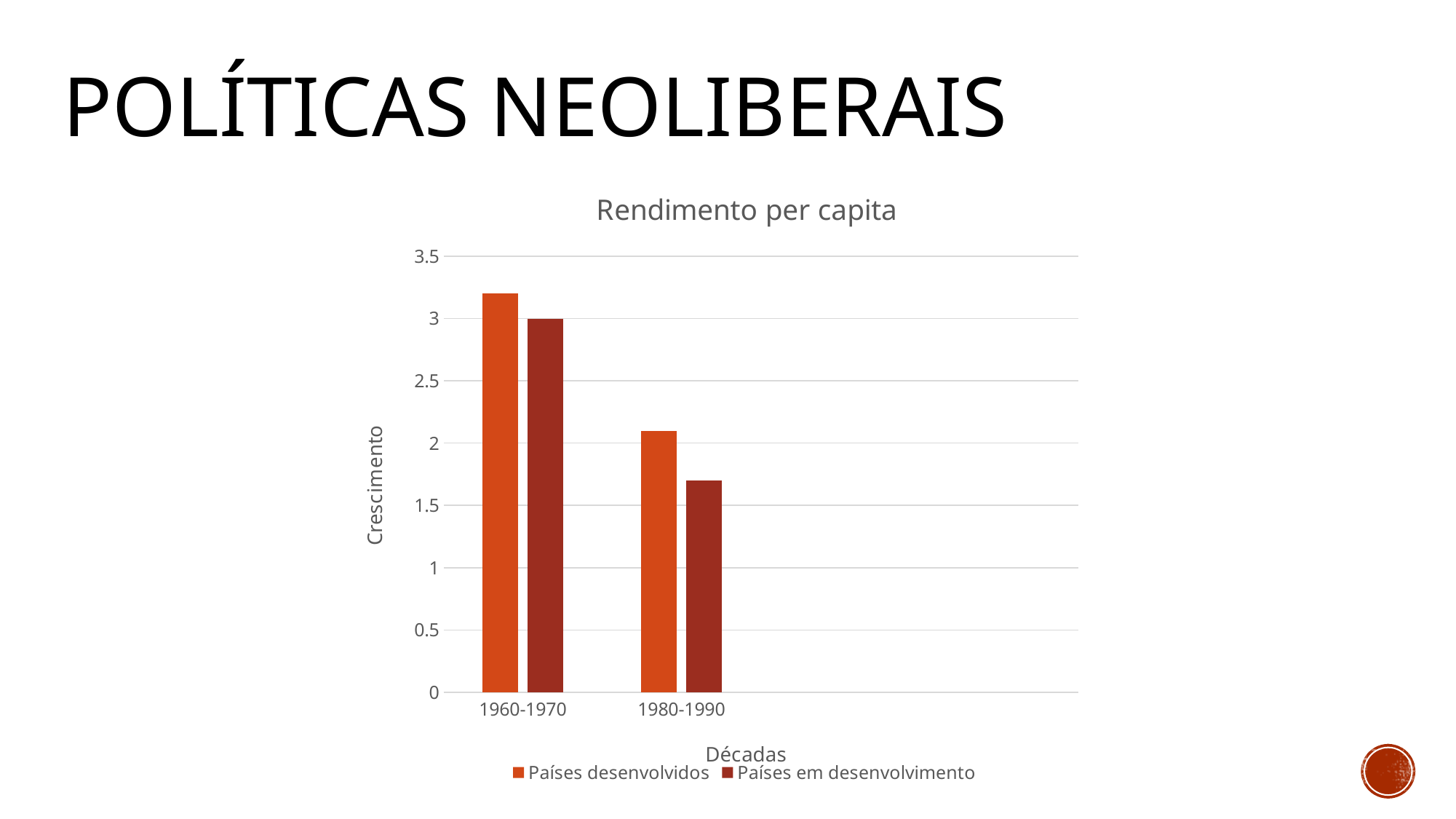
Do the values for Países em desenvolvimento rise or fall from 1960-1970 to 1980-1990? fall Is the value for Países em desenvolvimento in 1980-1990 greater or less than 2? less Is the value for Países desenvolvidos in 1960-1970 greater or less than 3? greater How many series does the legend list? 2 Is the value for Países desenvolvidos in 1980-1990 greater or less than 2? greater Which bar is the highest in the chart? Países desenvolvidos, 1960-1970 What is the title of the chart? Rendimento per capita In 1980-1990, which series has the larger value, Países desenvolvidos or Países em desenvolvimento? Países desenvolvidos Which bar is the lowest in the chart? Países em desenvolvimento, 1980-1990 What kind of chart is shown on the slide? bar chart How many decade categories are shown on the x axis? 2 What is the label of the vertical axis? Crescimento